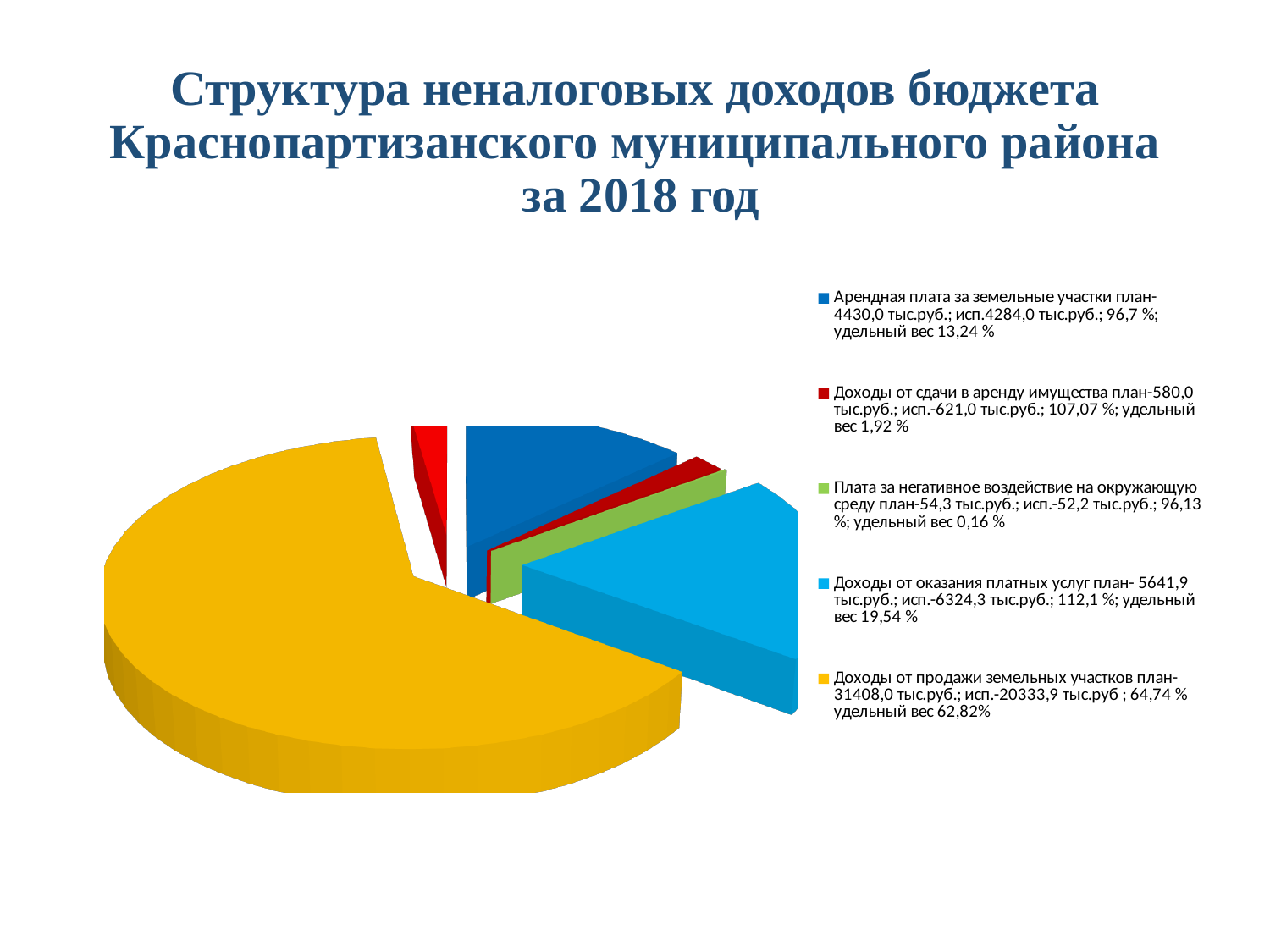
What kind of chart is shown on the slide? pie chart According to the legend, what is the share (удельный вес) of Доходы от оказания платных услуг? 19,54 % Which slice is larger: Доходы от оказания платных услуг or Арендная плата за земельные участки? Доходы от оказания платных услуг Which category has the smallest slice of the pie? Плата за негативное воздействие на окружающую среду Which category has the largest slice of the pie? Доходы от продажи земельных участков How many entries does the legend list? 5 What is the planned amount (план) for Плата за негативное воздействие на окружающую среду, as given in the legend? 54,3 тыс.руб. What colour is the slice for Доходы от продажи земельных участков? yellow What is the executed amount (исп.) for Доходы от сдачи в аренду имущества, as given in the legend? 621,0 тыс.руб. How many slices does the pie chart have? 6 According to the legend, what is the share (удельный вес) of Арендная плата за земельные участки? 13,24 % According to the legend, what is the share (удельный вес) of Доходы от продажи земельных участков? 62,82%